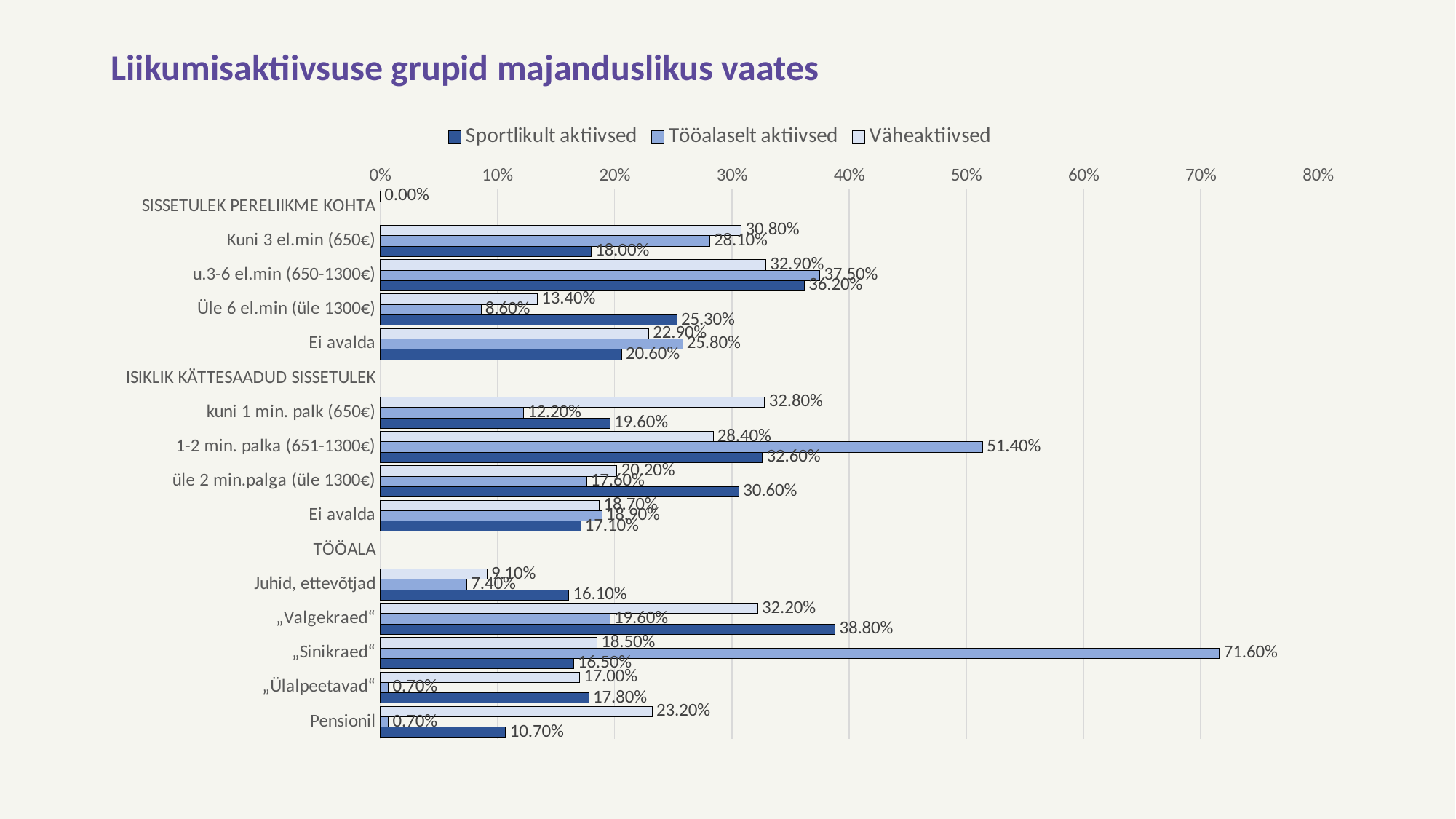
Which category has the lowest value for Sportlikult aktiivsed (excluding the section headings)? Pensionil Which category has the highest value for Tööalaselt aktiivsed? „Sinikraed“ How many series does the legend list? 3 What is the title of the chart? Liikumisaktiivsuse grupid majanduslikus vaates What type of chart is shown on the slide? Bar chart What is the value for Tööalaselt aktiivsed in the Pensionil category? 0.70% What is the value for Sportlikult aktiivsed in the „Valgekraed“ category? 38.80% Is the Sportlikult aktiivsed value for üle 2 min.palga (üle 1300€) greater or less than 20%? greater What is the value for Väheaktiivsed in the kuni 1 min. palk (650€) category? 32.80% For Üle 6 el.min (üle 1300€), which is larger: the Sportlikult aktiivsed value or the Väheaktiivsed value? Sportlikult aktiivsed What is the value for Tööalaselt aktiivsed in the „Sinikraed“ category? 71.60% What is the difference between the Tööalaselt aktiivsed and Sportlikult aktiivsed values for 1-2 min. palka (651-1300€)? 18.80%